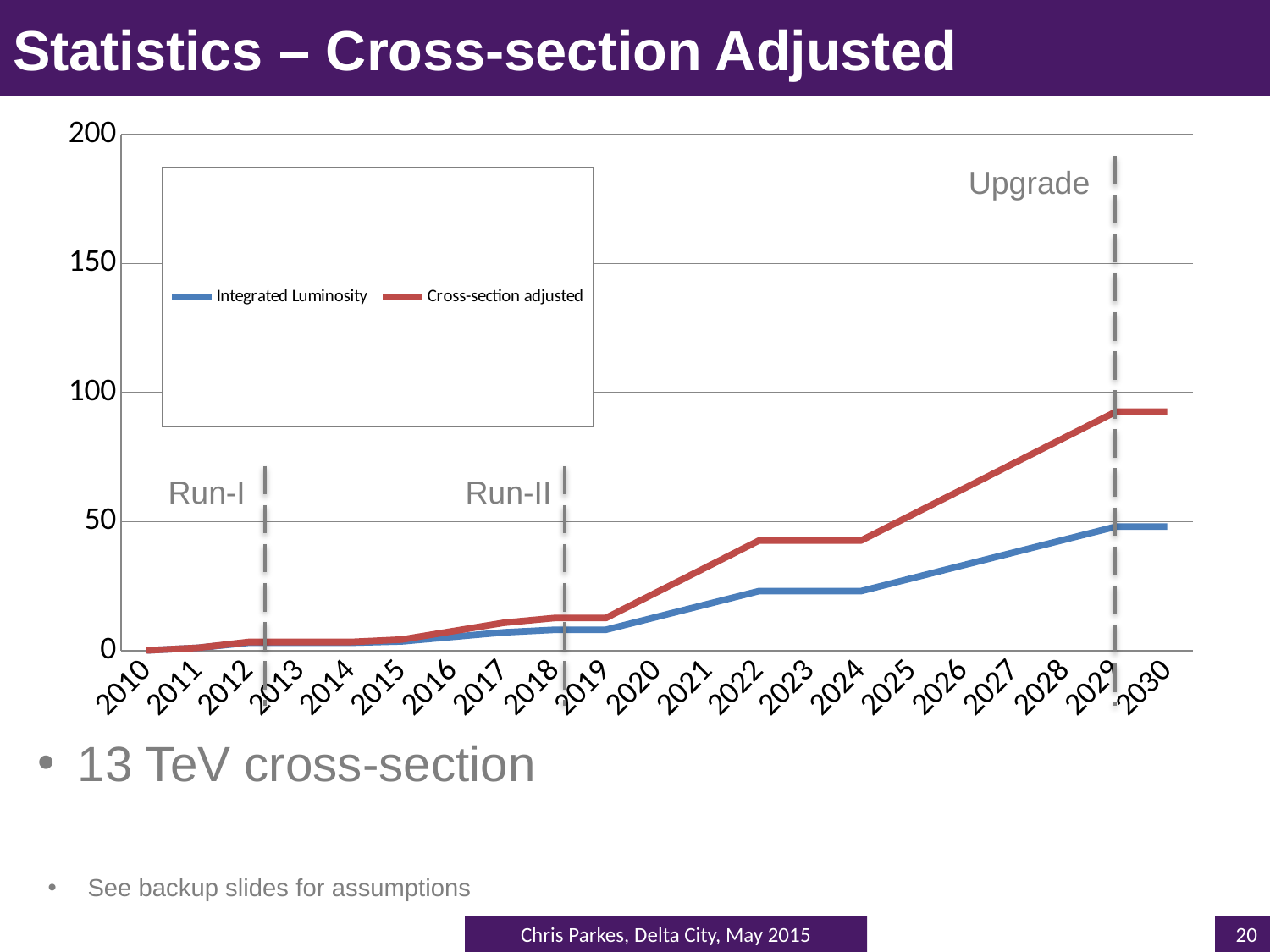
In 2030, which series has the higher value, Integrated Luminosity or Cross-section adjusted? Cross-section adjusted What are the two series named in the chart legend? Integrated Luminosity and Cross-section adjusted Which series is drawn in red on the chart? Cross-section adjusted Is the Integrated Luminosity value for 2024 greater or less than 50? less Is the Cross-section adjusted value for 2030 greater or less than 50? greater How many years are labelled along the x axis of the chart? 21 Does the Cross-section adjusted series generally rise or fall from 2010 to 2030? rise How many series does the chart legend list? 2 Is the Cross-section adjusted value for 2028 greater or less than 50? greater What kind of chart is shown on the slide? line chart In 2024, which series has the higher value, Integrated Luminosity or Cross-section adjusted? Cross-section adjusted